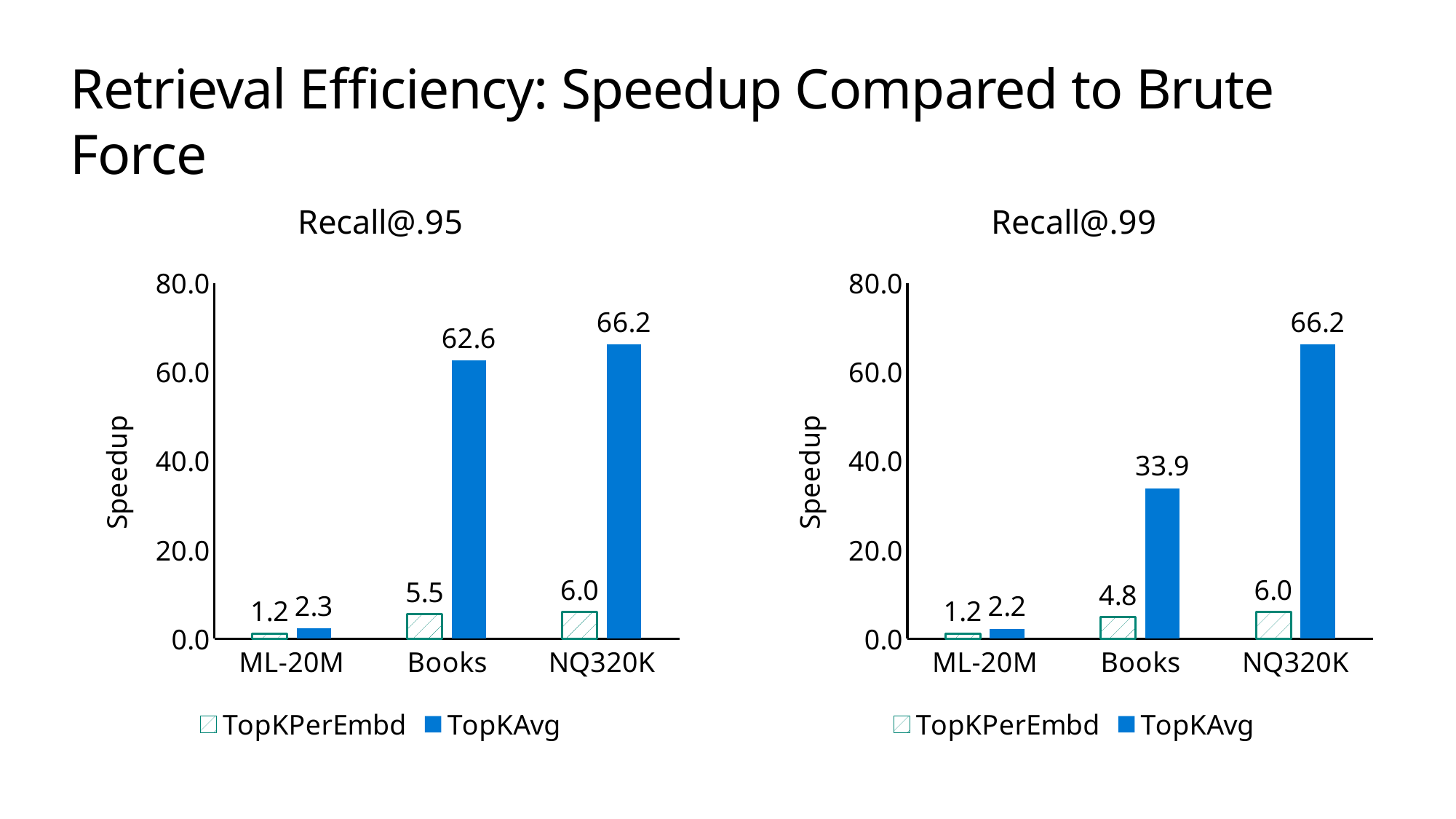
In the Recall@.95 chart, what is the TopKPerEmbd speedup for NQ320K? 6.0 In the Recall@.99 chart, what is the TopKAvg speedup for Books? 33.9 In the Recall@.99 chart, what is the difference between the TopKAvg speedups for NQ320K and Books? 32.3 In the Recall@.99 chart, which dataset has the lowest TopKPerEmbd speedup? ML-20M In the Recall@.95 chart, what is the difference between the TopKAvg and TopKPerEmbd speedups for Books? 57.1 In the Recall@.99 chart, what is the TopKAvg speedup for ML-20M? 2.2 How many datasets are shown on the x axis of the Recall@.99 chart? 3 In the Recall@.95 chart, which dataset has the highest TopKAvg speedup? NQ320K In the Recall@.95 chart, what is the TopKAvg speedup for Books? 62.6 In the Recall@.99 chart, which is larger for Books: the TopKAvg speedup or the TopKPerEmbd speedup? TopKAvg In the Recall@.95 chart, is the TopKAvg speedup for Books greater or less than 40.0? greater How many series does the legend of the Recall@.95 chart list? 2